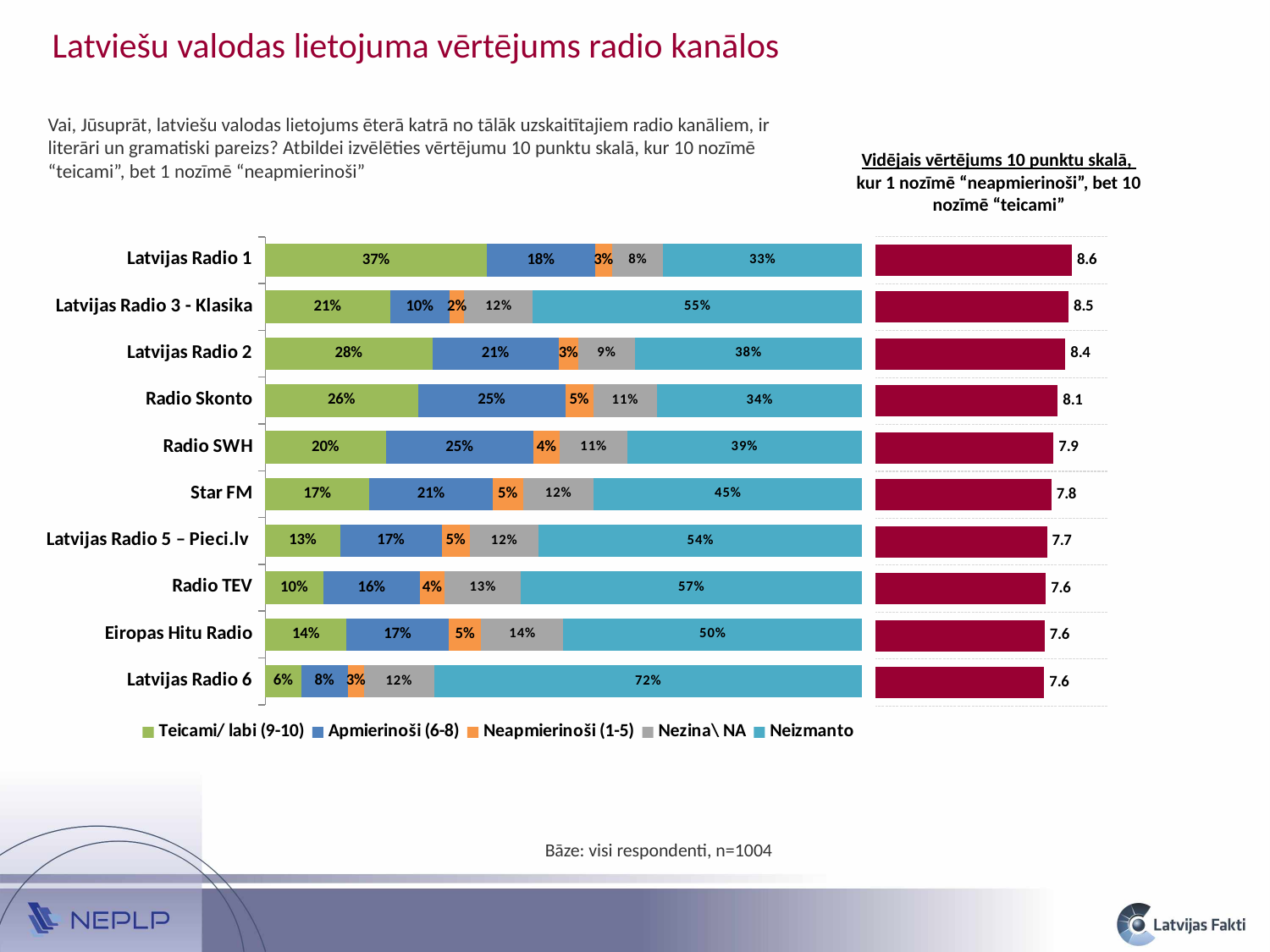
In the stacked bar chart on the left, what is the "Neizmanto" share for Latvijas Radio 6? 72% In the stacked bar chart on the left, what is the difference between the "Neizmanto" shares of Latvijas Radio 3 - Klasika and Latvijas Radio 2? 17% In the right-hand chart of average ratings, which radio channel has the highest average score? Latvijas Radio 1 In the right-hand chart of average ratings, what is the difference between the scores of Latvijas Radio 1 and Radio SWH? 0.7 In the stacked bar chart on the left, which legend entry is shown in orange? Neapmierinoši (1-5) In the right-hand chart of average ratings (Vidējais vērtējums 10 punktu skalā), what is the average score for Radio Skonto? 8.1 How many series does the legend of the stacked bar chart on the left list? 5 How many radio channels are shown in the stacked bar chart on the left? 10 In the stacked bar chart on the left, what percentage of respondents rated Latvijas Radio 1 as "Teicami/ labi (9-10)"? 37% In the stacked bar chart on the left, which has a larger "Apmierinoši (6-8)" share: Radio Skonto or Star FM? Radio Skonto What type of chart is the chart on the left of the slide? Stacked bar chart In the stacked bar chart on the left, which radio channel has the lowest "Teicami/ labi (9-10)" share? Latvijas Radio 6